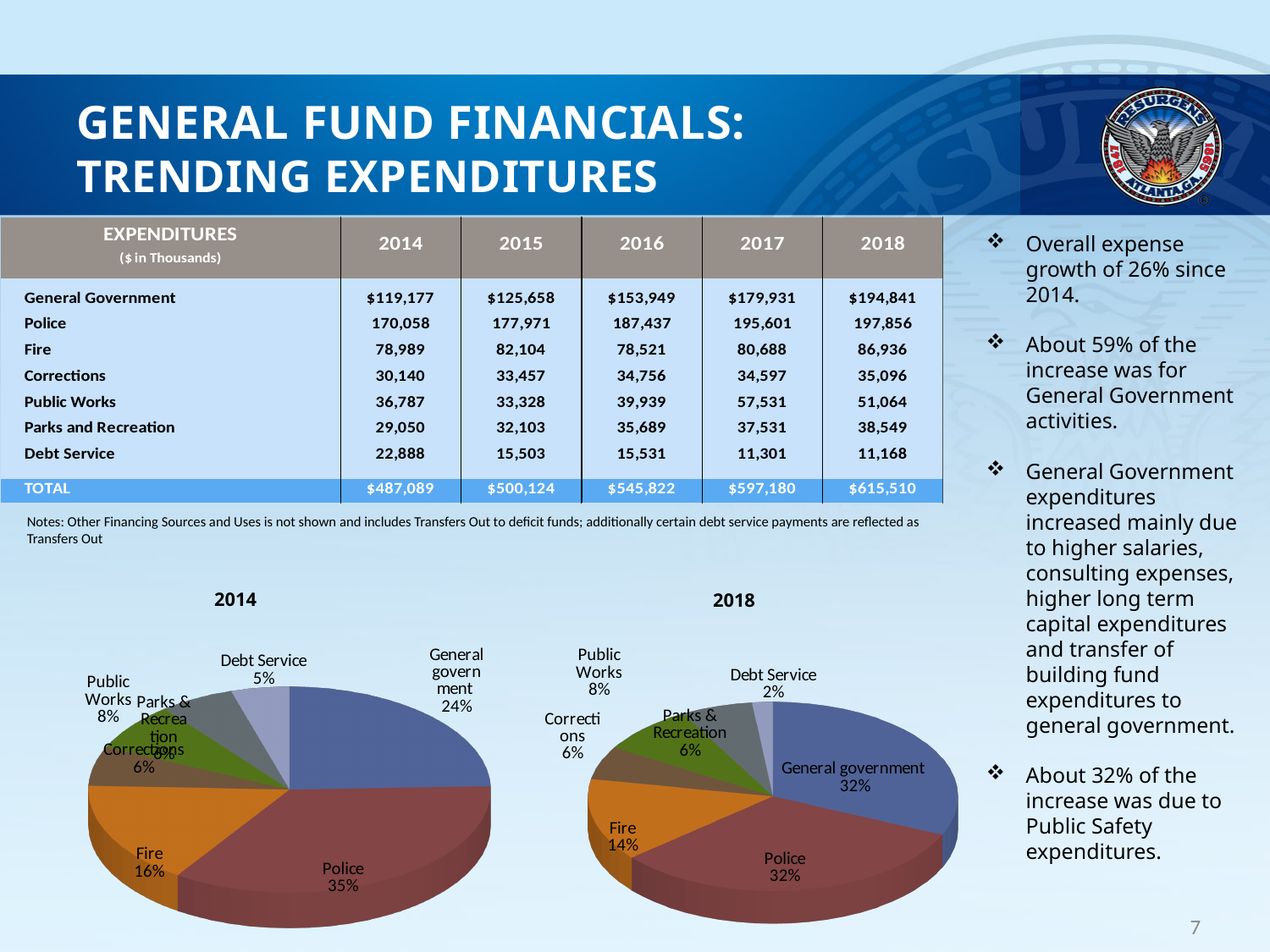
In the 2014 pie chart, which category has the largest share? Police In the 2014 pie chart, which is larger, the Fire share or the Public Works share? Fire In the 2014 pie chart, what share of expenditures is General government? 24% In the 2014 pie chart, what is the difference in percentage points between the Police share and the Fire share? 19 In the 2018 pie chart, what share of expenditures is Debt Service? 2% In the 2018 pie chart, what share of expenditures is Fire? 14% How many slices does the 2018 pie chart have? 7 In the 2018 pie chart, what is the difference in percentage points between the Public Works share and the Debt Service share? 6 In the 2018 pie chart, which category has the smallest share? Debt Service What are the titles of the two charts on the slide? 2014 and 2018 What type of chart is the 2014 chart? Pie chart